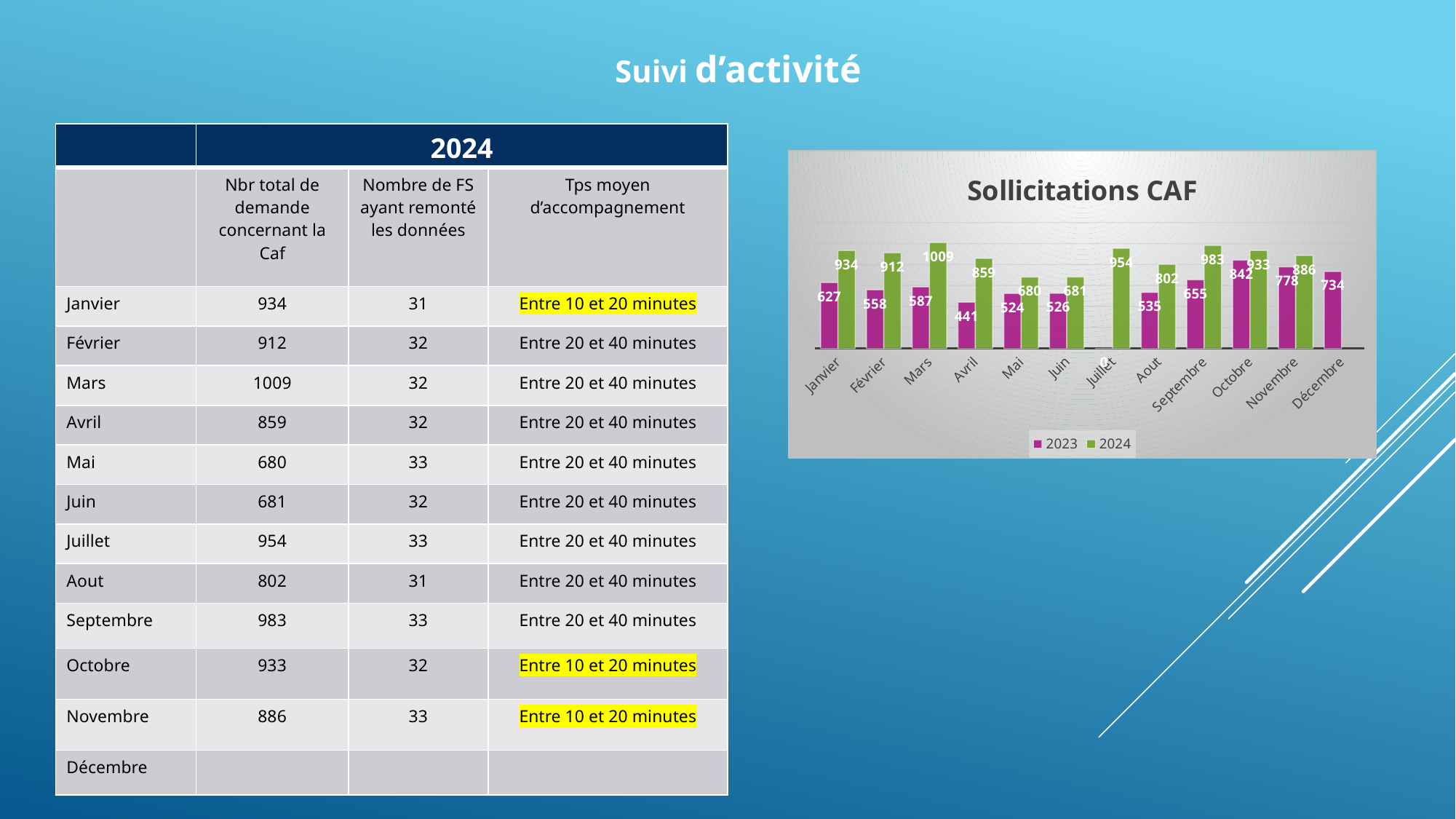
In the 'Sollicitations CAF' chart, what is the 2024 value for Mars? 1009 What type of chart is 'Sollicitations CAF'? bar chart How many months are shown on the x axis of the 'Sollicitations CAF' chart? 12 In the 'Sollicitations CAF' chart, what is the 2024 value for Juillet? 954 In the 'Sollicitations CAF' chart, which colour represents the 2024 series? green In the 'Sollicitations CAF' chart, which month has the highest 2024 value? Mars In the 'Sollicitations CAF' chart, what is the 2023 value for Octobre? 842 In the 'Sollicitations CAF' chart, which is larger for Septembre: the 2023 value or the 2024 value? 2024 How many series does the legend of the 'Sollicitations CAF' chart list? 2 In the 'Sollicitations CAF' chart, what is the difference between the 2024 and 2023 values for Janvier? 307 In the 'Sollicitations CAF' chart, which month has the lowest 2023 value among the months with a 2023 bar? Avril In the 'Sollicitations CAF' chart, what is the 2023 value for Avril? 441